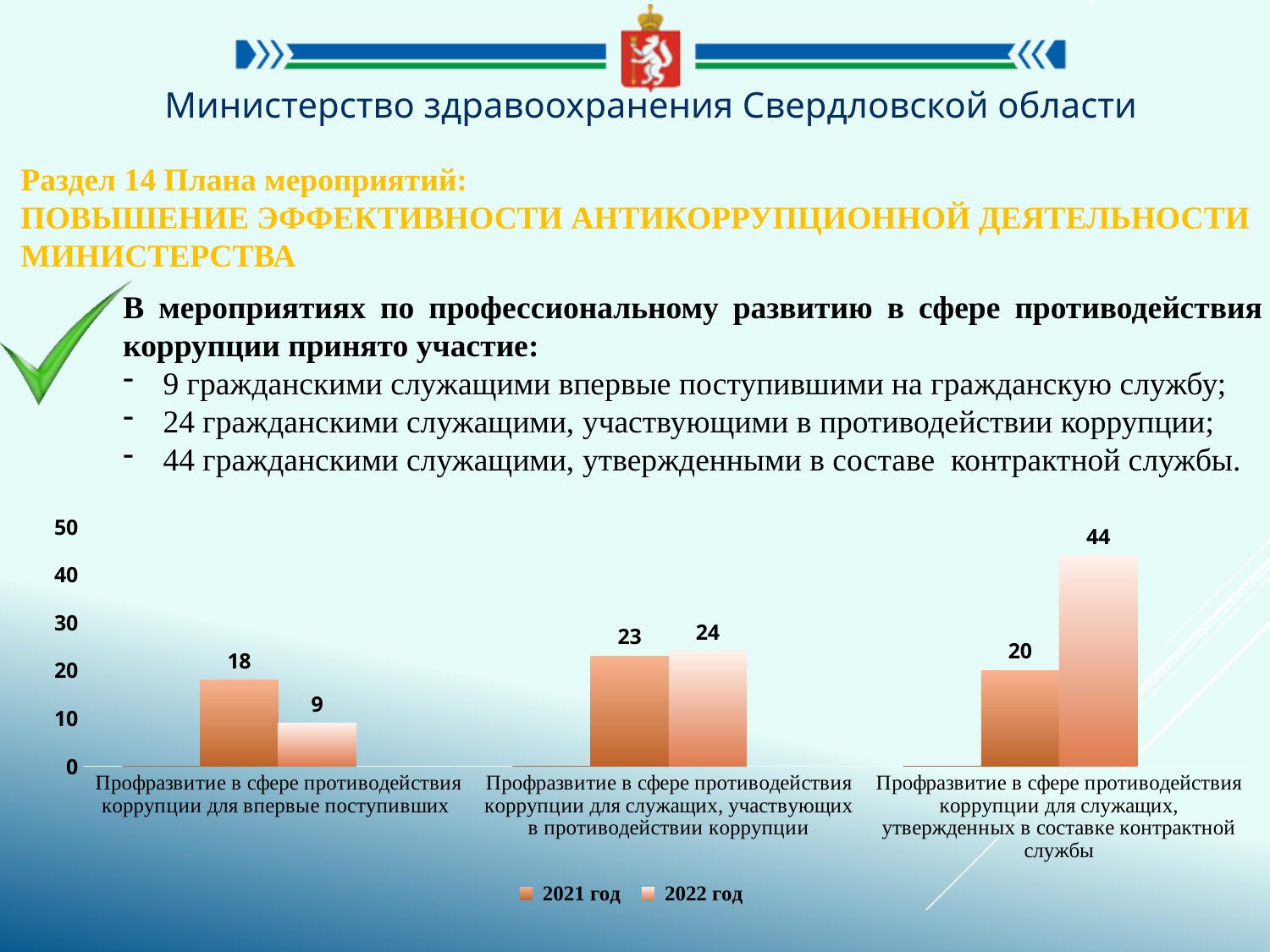
Is the value for 2021 год in the category 'Профразвитие в сфере противодействия коррупции для служащих, участвующих в противодействии коррупции' greater or less than 20? greater What is the value for 2021 год in the category 'Профразвитие в сфере противодействия коррупции для впервые поступивших'? 18 What are the two series named in the chart legend? 2021 год and 2022 год Which category has the lowest value for 2022 год? Профразвитие в сфере противодействия коррупции для впервые поступивших In the category 'Профразвитие в сфере противодействия коррупции для впервые поступивших', which year has the larger value, 2021 год or 2022 год? 2021 год What is the value for 2022 год in the category 'Профразвитие в сфере противодействия коррупции для служащих, участвующих в противодействии коррупции'? 24 Which category has the highest value for 2022 год? Профразвитие в сфере противодействия коррупции для служащих, утвержденных в составке контрактной службы How many categories are shown on the x axis of the chart? 3 What kind of chart is shown on the slide? bar chart What is the difference between the 2022 год and 2021 год values in the category 'Профразвитие в сфере противодействия коррупции для служащих, утвержденных в составке контрактной службы'? 24 How many series does the chart legend list? 2 What is the value for 2022 год in the category 'Профразвитие в сфере противодействия коррупции для служащих, утвержденных в составке контрактной службы'? 44